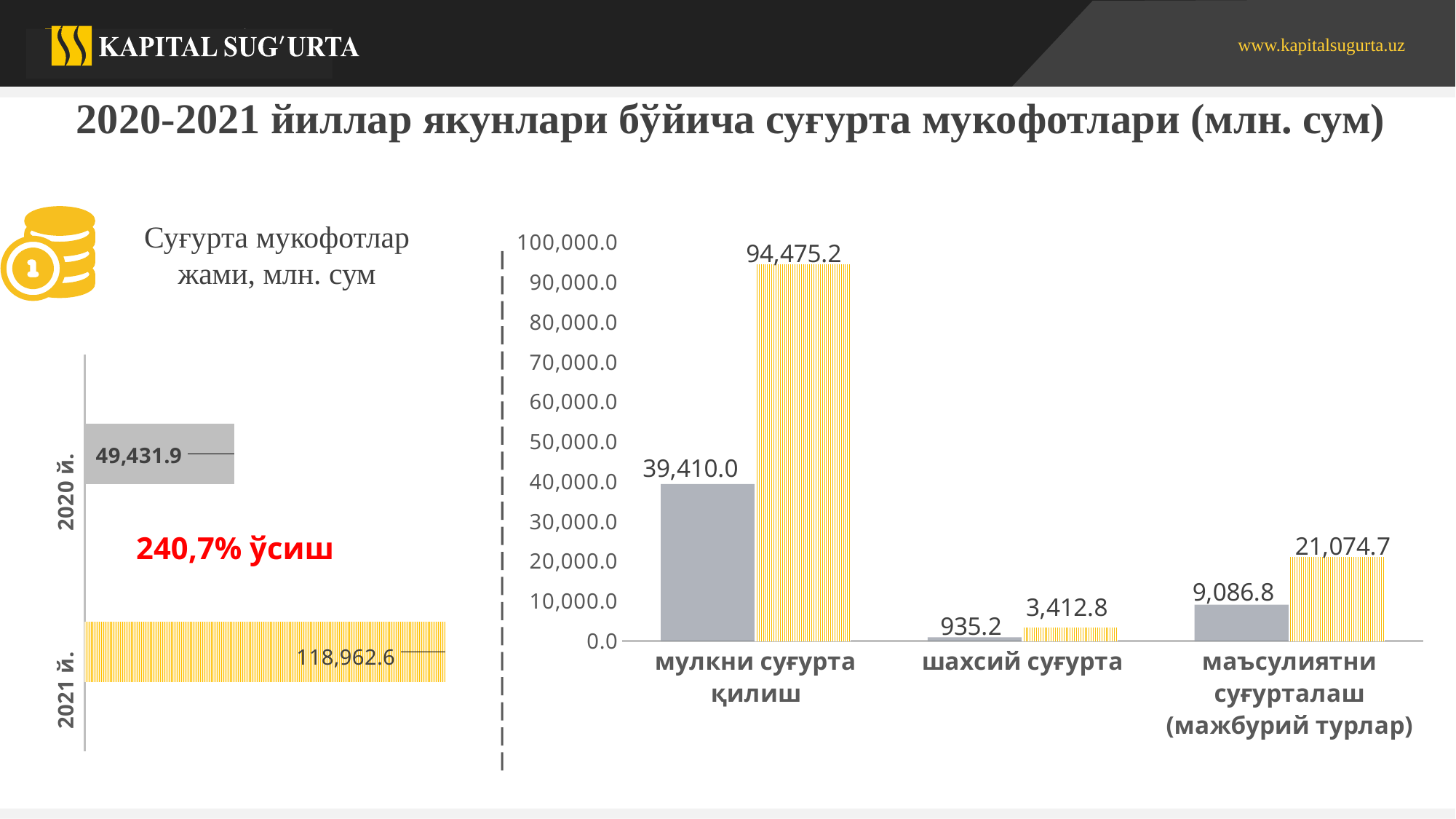
In the right chart, what is the value of the yellow striped bar for маъсулиятни суғурталаш (мажбурий турлар)? 21,074.7 In the left chart (Суғурта мукофотлар жами, млн. сум), what is the value for 2020 й.? 49,431.9 What kind of chart is the left chart (Суғурта мукофотлар жами, млн. сум)? bar chart In the right chart, what is the value of the grey bar for шахсий суғурта? 935.2 In the right chart, which category has the lowest yellow striped bar? шахсий суғурта In the left chart (Суғурта мукофотлар жами, млн. сум), what is the difference between the 2021 й. and 2020 й. values? 69,530.7 In the left chart (Суғурта мукофотлар жами, млн. сум), what growth percentage is shown in red text? 240,7% ўсиш In the right chart, which category has the highest grey bar? мулкни суғурта қилиш In the left chart (Суғурта мукофотлар жами, млн. сум), what is the value for 2021 й.? 118,962.6 In the right chart, what is the value of the yellow striped bar for мулкни суғурта қилиш? 94,475.2 How many categories are shown on the x axis of the right chart? 3 In the right chart, what is the difference between the yellow striped bar and the grey bar for мулкни суғурта қилиш? 55,065.2